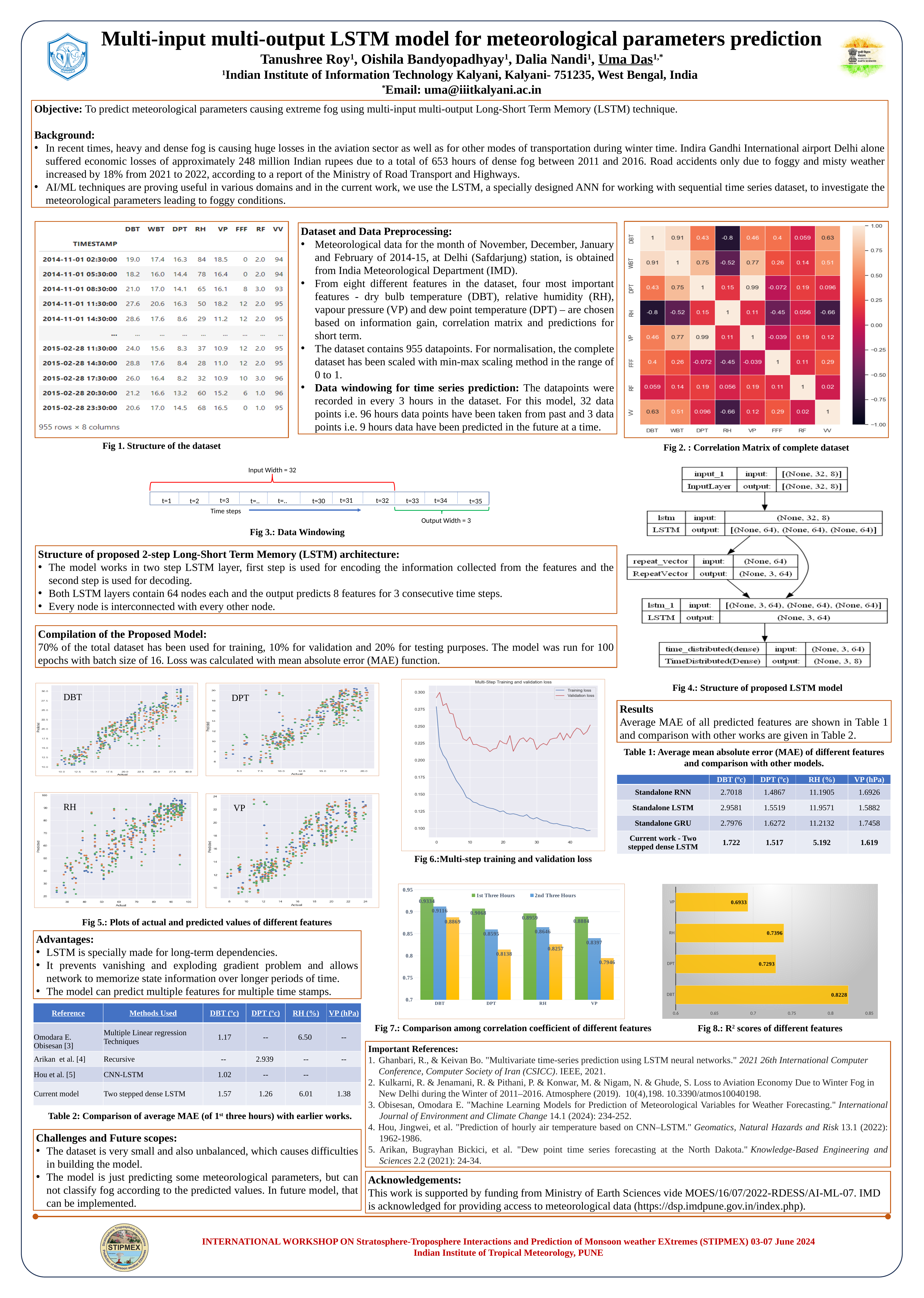
In Fig 8 (R² scores of different features), what kind of chart is shown? Bar chart In Fig 7 (comparison among correlation coefficient of different features), what is the 1st Three Hours value for DBT? 0.9334 In Fig 8 (R² scores of different features), what is the R² score for DBT? 0.8228 In Fig 8 (R² scores of different features), how many features are plotted? 4 In Fig 7 (comparison among correlation coefficient of different features), what is the difference between the 1st Three Hours and 2nd Three Hours values for DPT? 0.0473 In Fig 7 (comparison among correlation coefficient of different features), what is the 2nd Three Hours value for RH? 0.8646 In Fig 8 (R² scores of different features), what is the R² score for VP? 0.6933 In Fig 8 (R² scores of different features), which feature has the lowest R² score? VP In Fig 8 (R² scores of different features), which feature has the highest R² score? DBT In Fig 6 (multi-step training and validation loss), what kind of chart is shown? Line chart In Fig 7 (comparison among correlation coefficient of different features), which feature has the highest 1st Three Hours value? DBT In Fig 7 (comparison among correlation coefficient of different features), is the 2nd Three Hours value for VP greater or less than 0.85? less